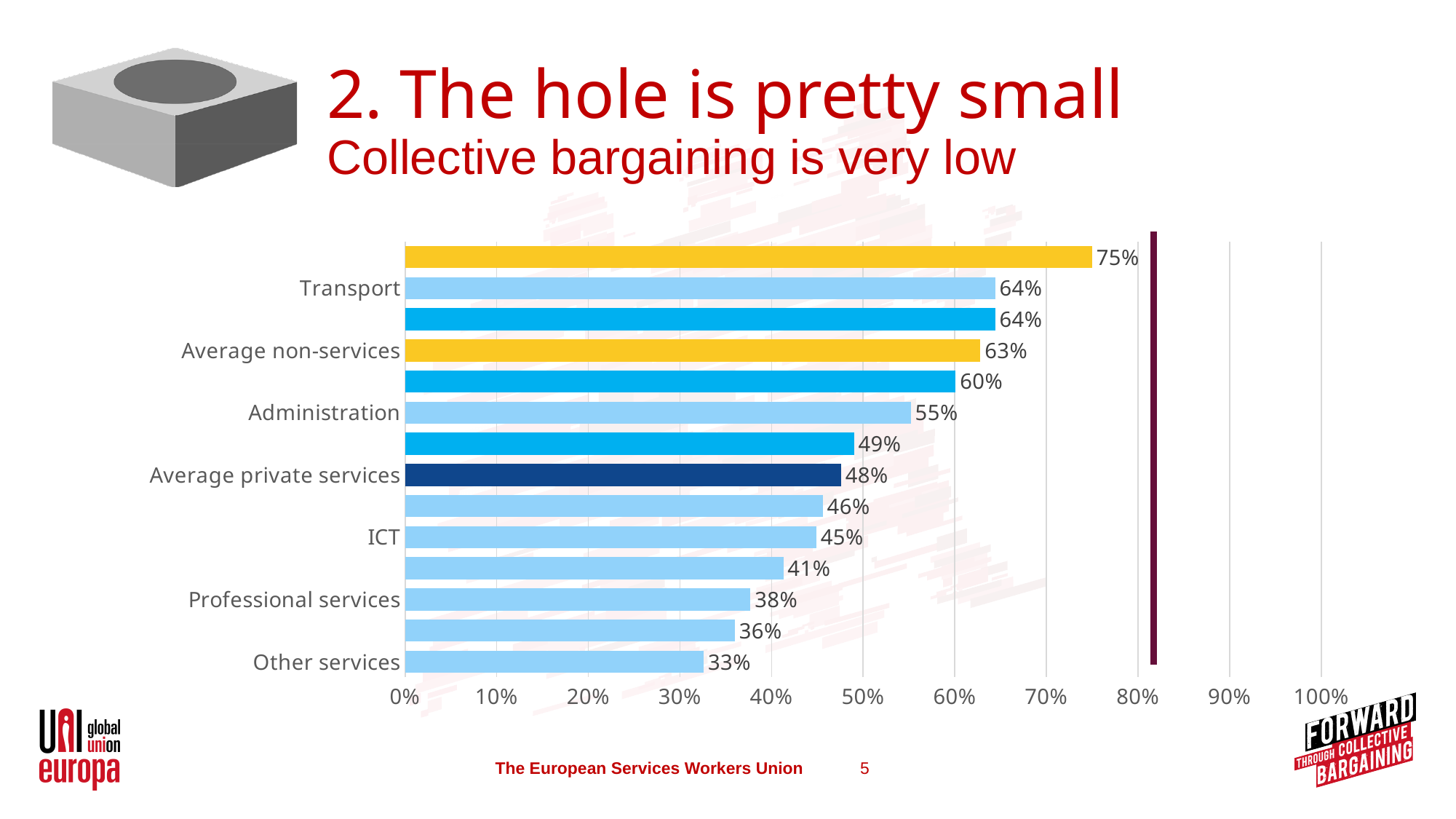
What is the difference between the values for Transport and Other services? 31 percentage points What is the value for Average non-services? 63% What colour is the bar for Average private services? dark blue What is the highest value shown on the chart? 75% Which labelled category has the lowest value? Other services What kind of chart is shown on the slide? bar chart What is the value for Average private services? 48% Which is larger, the value for Administration or the value for ICT? Administration What is the value for Administration? 55% What is the value for Professional services? 38% How many bars are plotted on the chart? 14 What is the value for Transport? 64%